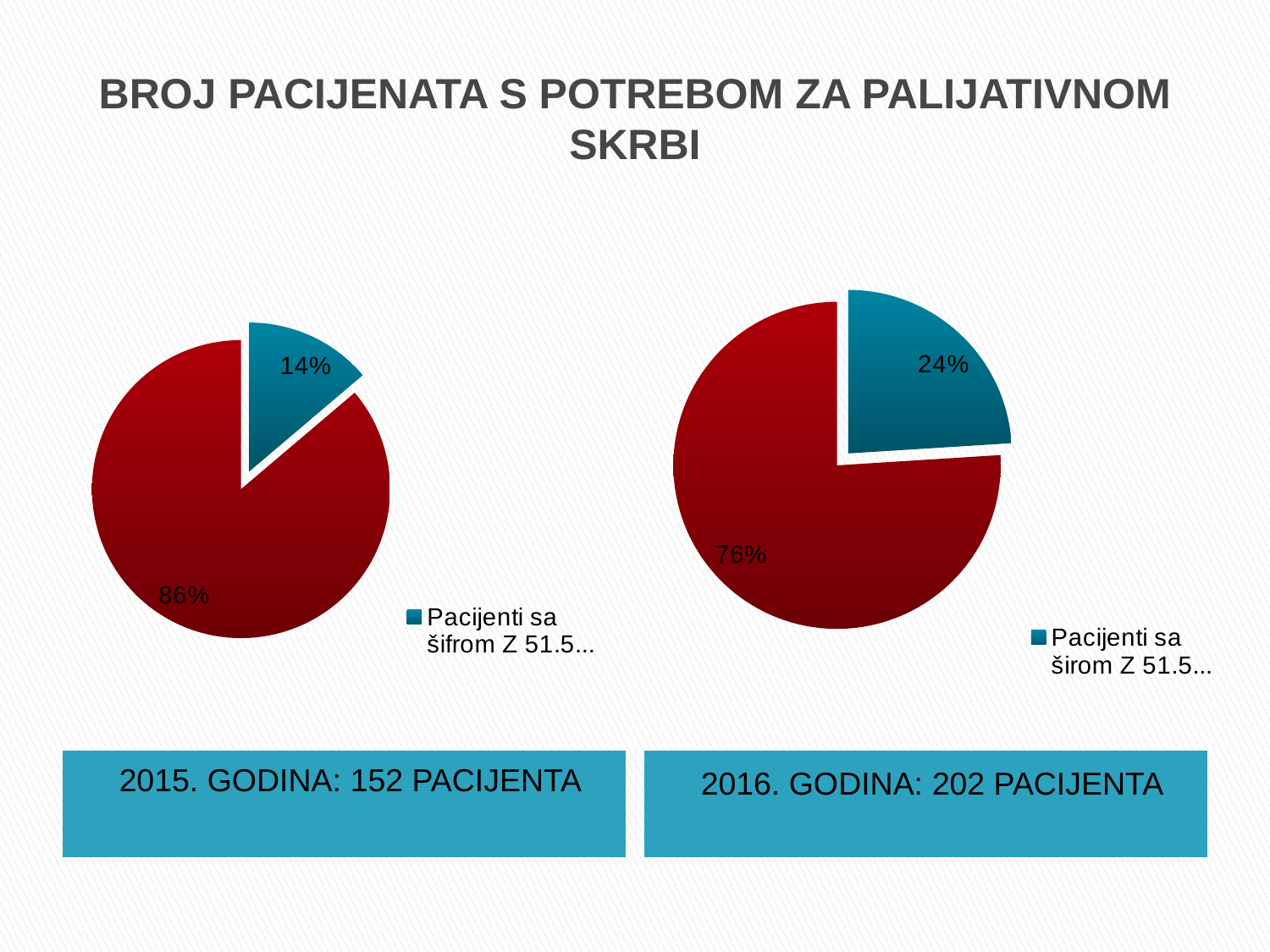
In the right pie chart (2016), what is the difference in percentage points between the red slice and the blue slice? 52 percentage points In the left pie chart (2015), what is the difference in percentage points between the red slice and the blue slice? 72 percentage points In the right pie chart (2016), which slice is the smallest? Pacijenti sa širom Z 51.5... (24%) Is the blue slice larger in the left pie chart (2015) or in the right pie chart (2016)? Right pie chart (2016) What type of chart is used on this slide? Pie chart In the right pie chart (2016), what percentage is shown on the red slice? 76% In the left pie chart (2015), which slice is the largest? The red slice (86%) How many slices does the left pie chart (2015) have? 2 In the right pie chart (2016), what percentage is shown for the slice labelled 'Pacijenti sa širom Z 51.5...'? 24% What is the title of the slide containing the two pie charts? BROJ PACIJENATA S POTREBOM ZA PALIJATIVNOM SKRBI In the left pie chart (2015), what percentage is shown for the slice labelled 'Pacijenti sa šifrom Z 51.5...'? 14% In the left pie chart (2015), what percentage is shown on the red slice? 86%